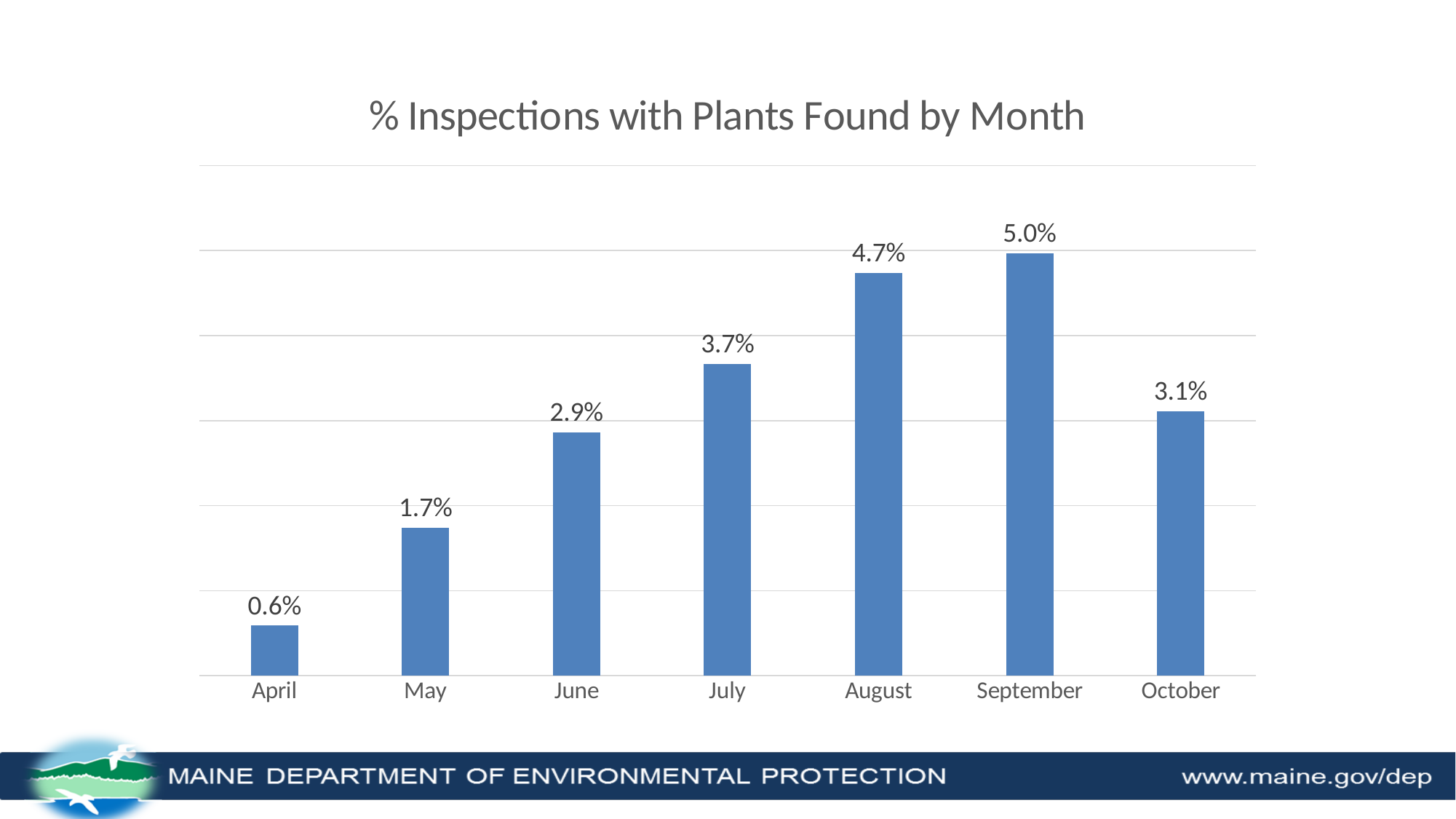
What is the value for April? 0.6% What kind of chart is this? Bar chart What is the value for October? 3.1% What is the value for July? 3.7% Do the values rise or fall from April to September? Rise What is the difference between the values for June and May? 1.2% Which is larger, the value for July or the value for October? July What is the title of the chart? % Inspections with Plants Found by Month How many months are shown on the x axis? 7 Which month has the highest percentage of inspections with plants found? September What is the difference between the values for September and August? 0.3% Which month has the lowest percentage of inspections with plants found? April